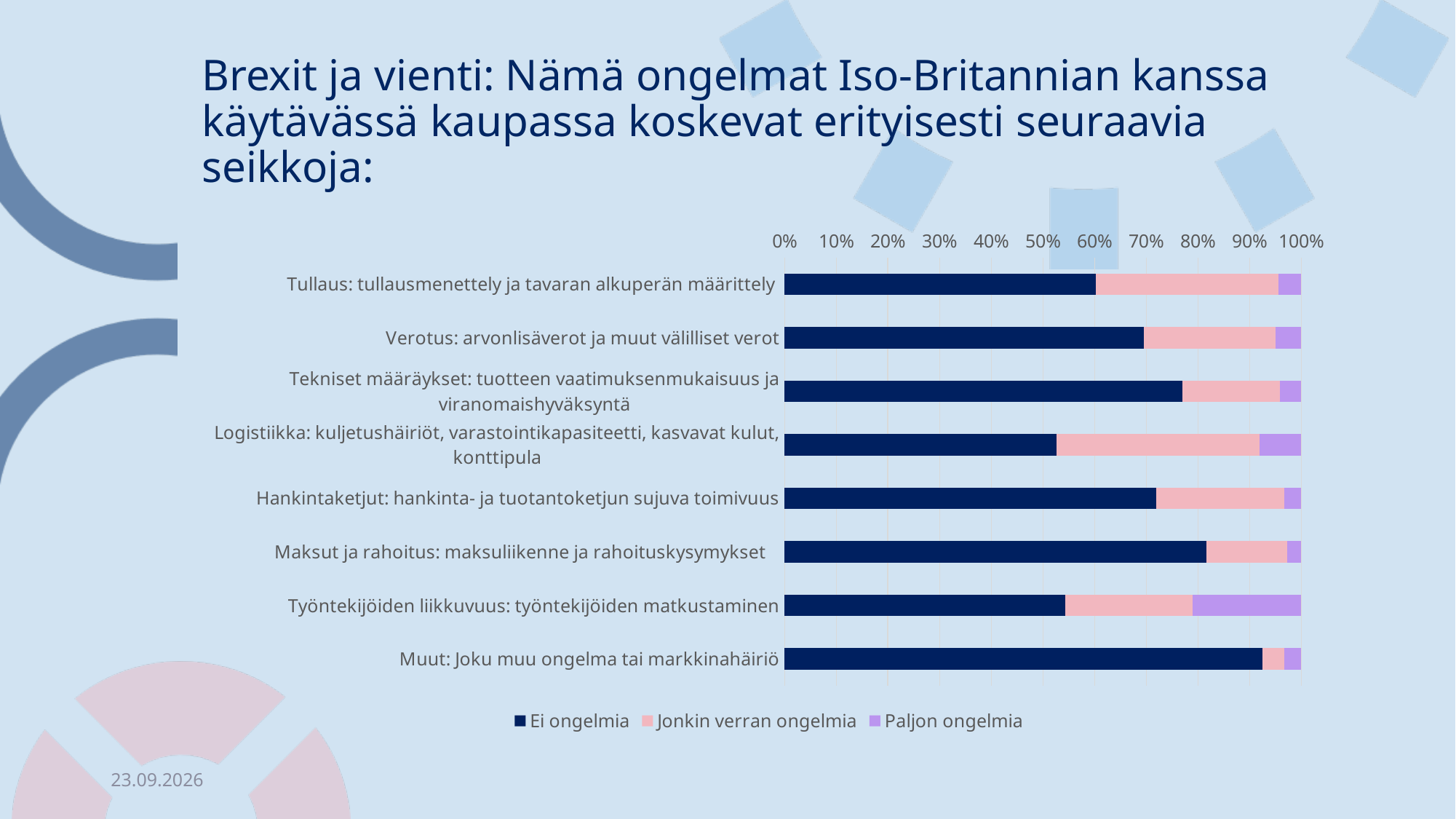
Is the 'Paljon ongelmia' share for 'Työntekijöiden liikkuvuus: työntekijöiden matkustaminen' greater or less than 10%? greater Is the 'Ei ongelmia' share for 'Tullaus: tullausmenettely ja tavaran alkuperän määrittely' greater or less than 50%? greater Is the 'Ei ongelmia' share for 'Logistiikka: kuljetushäiriöt, varastointikapasiteetti, kasvavat kulut, konttipula' greater or less than 60%? less Which category has the largest 'Ei ongelmia' share? Muut: Joku muu ongelma tai markkinahäiriö Which has the larger 'Ei ongelmia' share: 'Tullaus: tullausmenettely ja tavaran alkuperän määrittely' or 'Logistiikka: kuljetushäiriöt, varastointikapasiteetti, kasvavat kulut, konttipula'? Tullaus: tullausmenettely ja tavaran alkuperän määrittely Which category has the largest 'Paljon ongelmia' share? Työntekijöiden liikkuvuus: työntekijöiden matkustaminen What kind of chart is shown on the slide? Stacked bar chart How many categories (problem areas) are plotted in the chart? 8 Which has the larger 'Ei ongelmia' share: 'Verotus: arvonlisäverot ja muut välilliset verot' or 'Tullaus: tullausmenettely ja tavaran alkuperän määrittely'? Verotus: arvonlisäverot ja muut välilliset verot What are the three series listed in the legend? Ei ongelmia, Jonkin verran ongelmia, Paljon ongelmia How many series does the legend list? 3